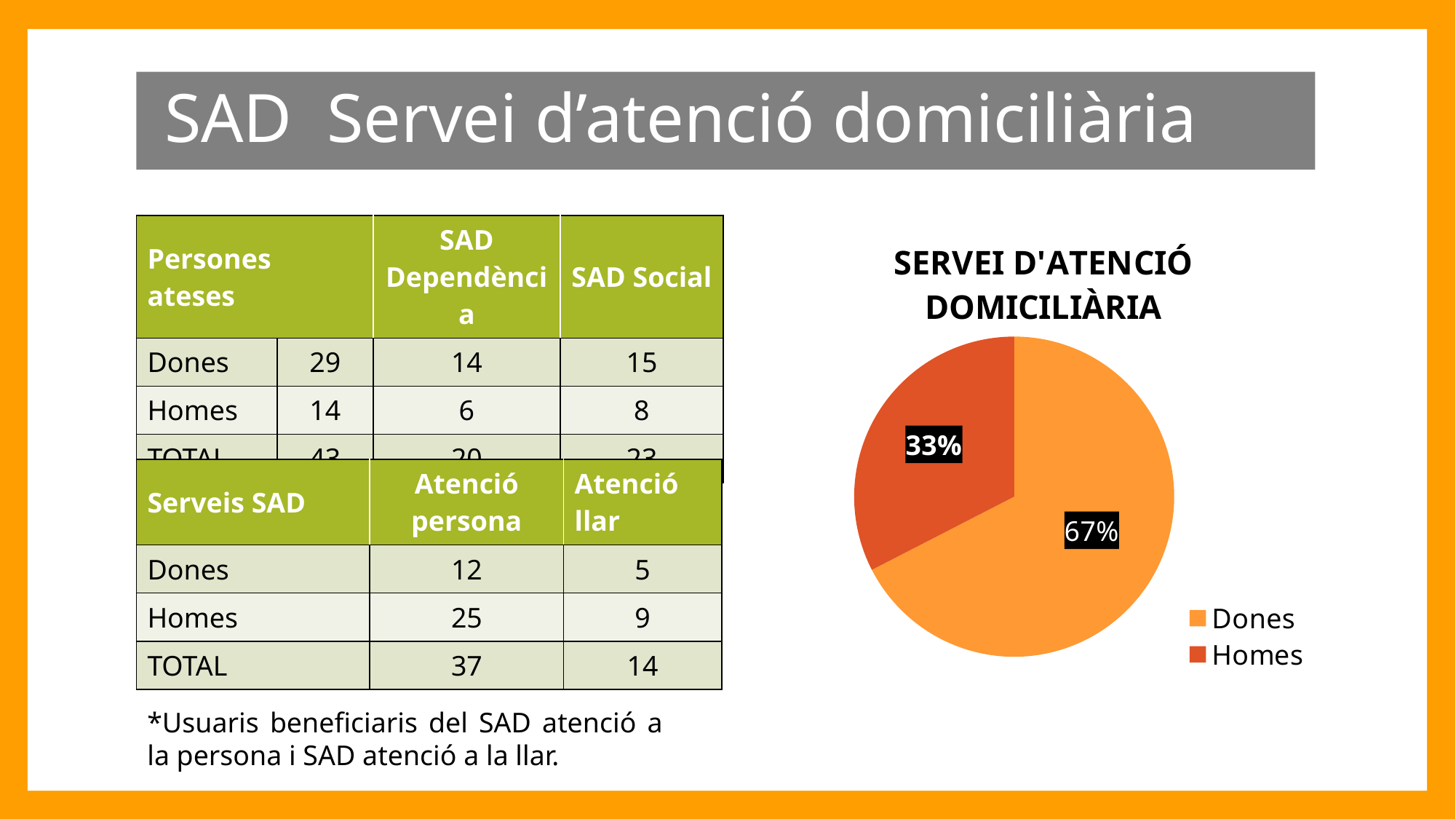
What is the difference in percentage points between the Dones and Homes slices? 34 What percentage of the pie chart does Dones represent? 67% What kind of chart is shown on the slide? pie chart What percentage of the pie chart does Homes represent? 33% What is the title of the pie chart? SERVEI D'ATENCIÓ DOMICILIÀRIA Which slice of the pie chart is the largest? Dones Which slice of the pie chart is the smallest? Homes How many entries does the pie chart legend list? 2 How many slices does the pie chart have? 2 Which legend entry is shown in the darker red-orange colour? Homes Which is larger in the pie chart, Dones or Homes? Dones